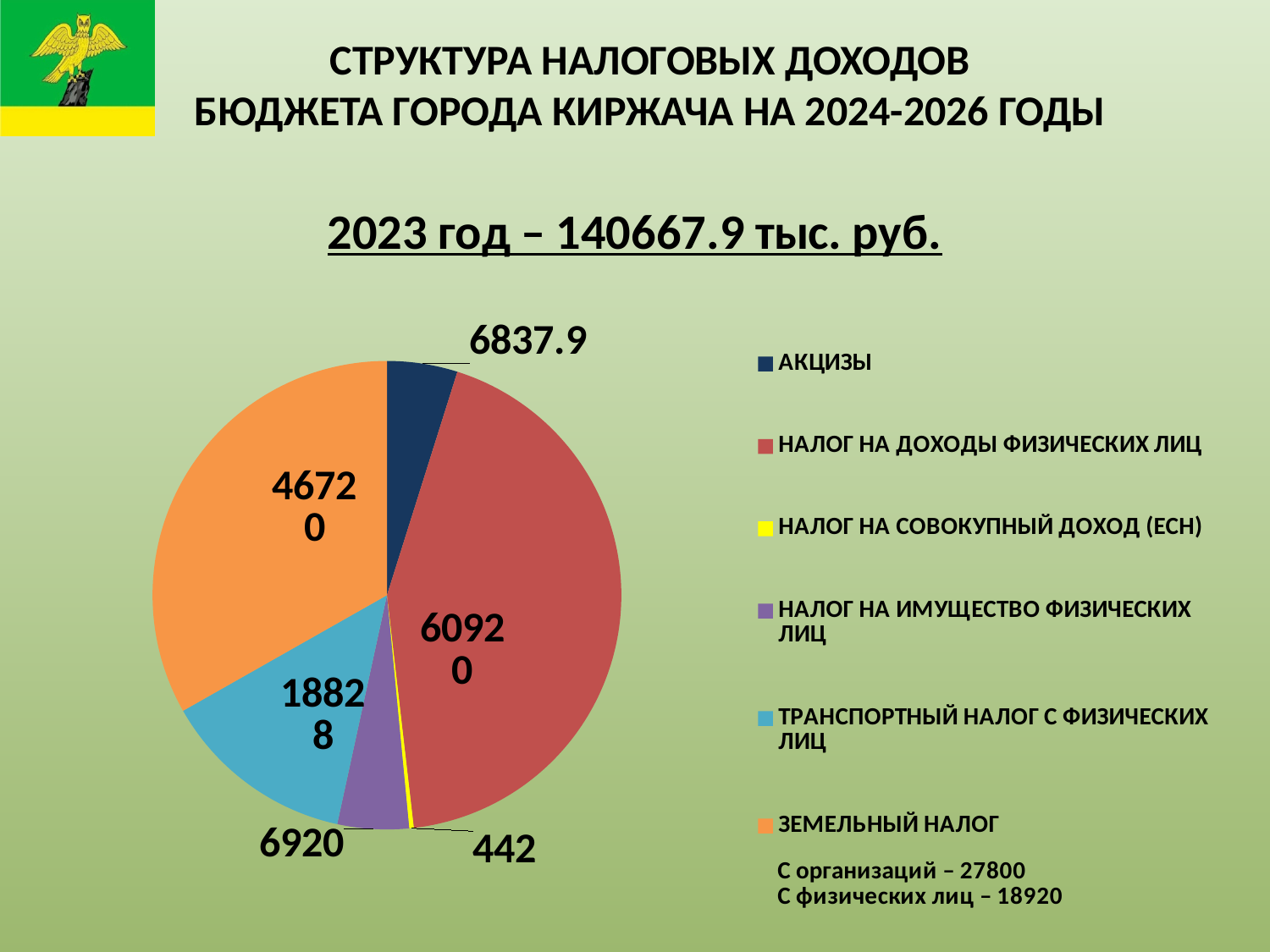
What is the value for АКЦИЗЫ in the pie chart? 6837.9 How many entries does the legend list? 6 What is the difference between the values for НАЛОГ НА ДОХОДЫ ФИЗИЧЕСКИХ ЛИЦ and ЗЕМЕЛЬНЫЙ НАЛОГ? 14200 What is the value for НАЛОГ НА ДОХОДЫ ФИЗИЧЕСКИХ ЛИЦ in the pie chart? 60920 Which category has the largest slice in the pie chart? НАЛОГ НА ДОХОДЫ ФИЗИЧЕСКИХ ЛИЦ What colour is the slice for ЗЕМЕЛЬНЫЙ НАЛОГ? orange What is the value for ЗЕМЕЛЬНЫЙ НАЛОГ in the pie chart? 46720 Which category has the smallest slice in the pie chart? НАЛОГ НА СОВОКУПНЫЙ ДОХОД (ЕСН) Which is larger: ЗЕМЕЛЬНЫЙ НАЛОГ or ТРАНСПОРТНЫЙ НАЛОГ С ФИЗИЧЕСКИХ ЛИЦ? ЗЕМЕЛЬНЫЙ НАЛОГ What type of chart is shown on the slide? pie chart How many slices does the pie chart have? 6 What is the value for ТРАНСПОРТНЫЙ НАЛОГ С ФИЗИЧЕСКИХ ЛИЦ in the pie chart? 18828